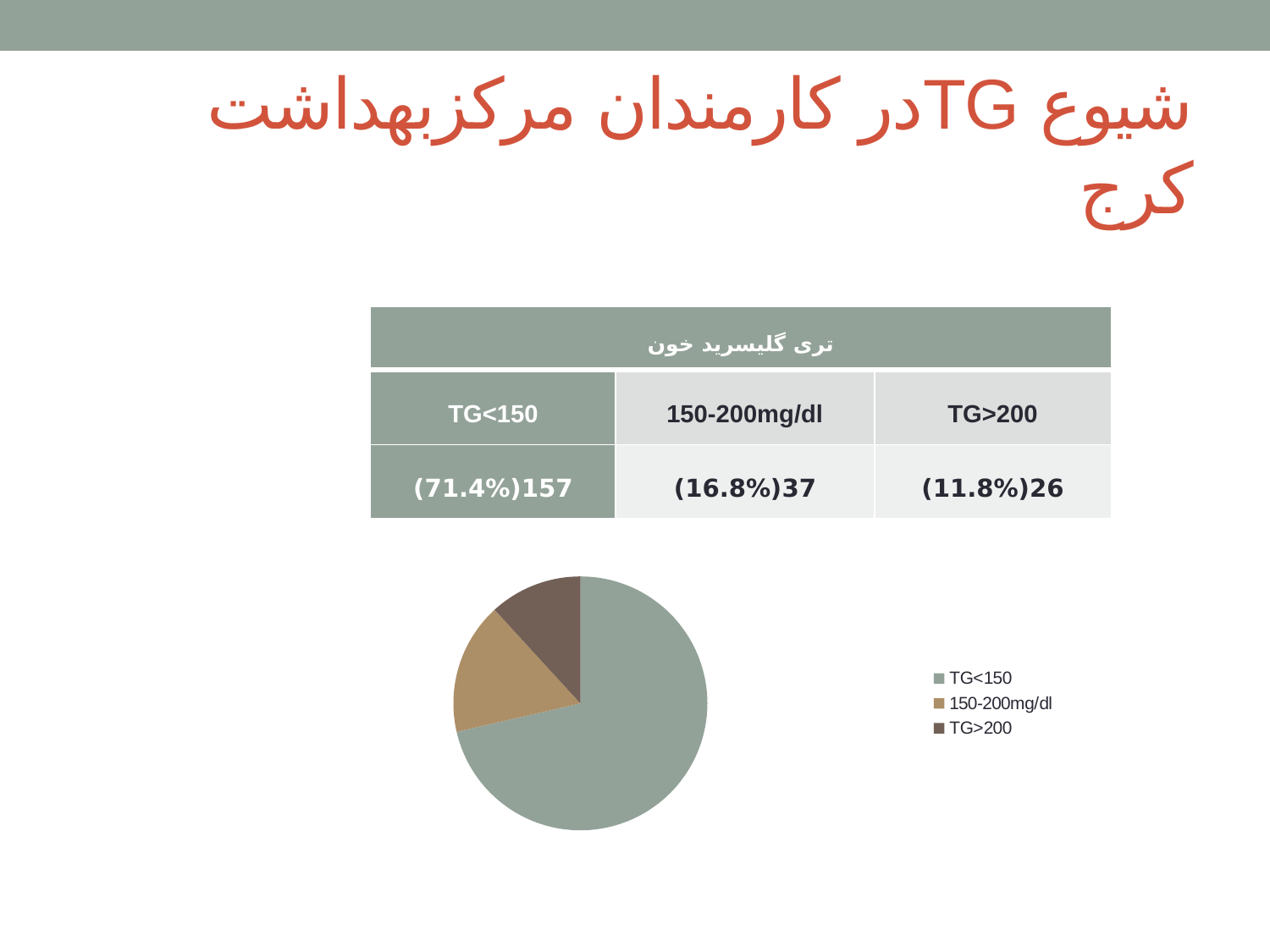
Which category has the smallest slice in the pie chart? TG>200 Which legend entry is shown in the darkest brown colour in the pie chart? TG>200 How many slices does the pie chart have? 3 What is the count for the 150-200mg/dl category shown in the table above the pie chart? 37 What is the count for the TG<150 category shown in the table above the pie chart? 157 How many entries does the pie chart's legend list? 3 Is the slice for 150-200mg/dl larger or smaller than the slice for TG>200? larger What is the difference between the counts for TG<150 and 150-200mg/dl in the table? 120 What share of the pie does the TG>200 slice represent, according to the table on the slide? 11.8% What kind of chart is shown on the slide? pie chart Which category has the largest slice in the pie chart? TG<150 What share of the pie does the TG<150 slice represent, according to the table on the slide? 71.4%